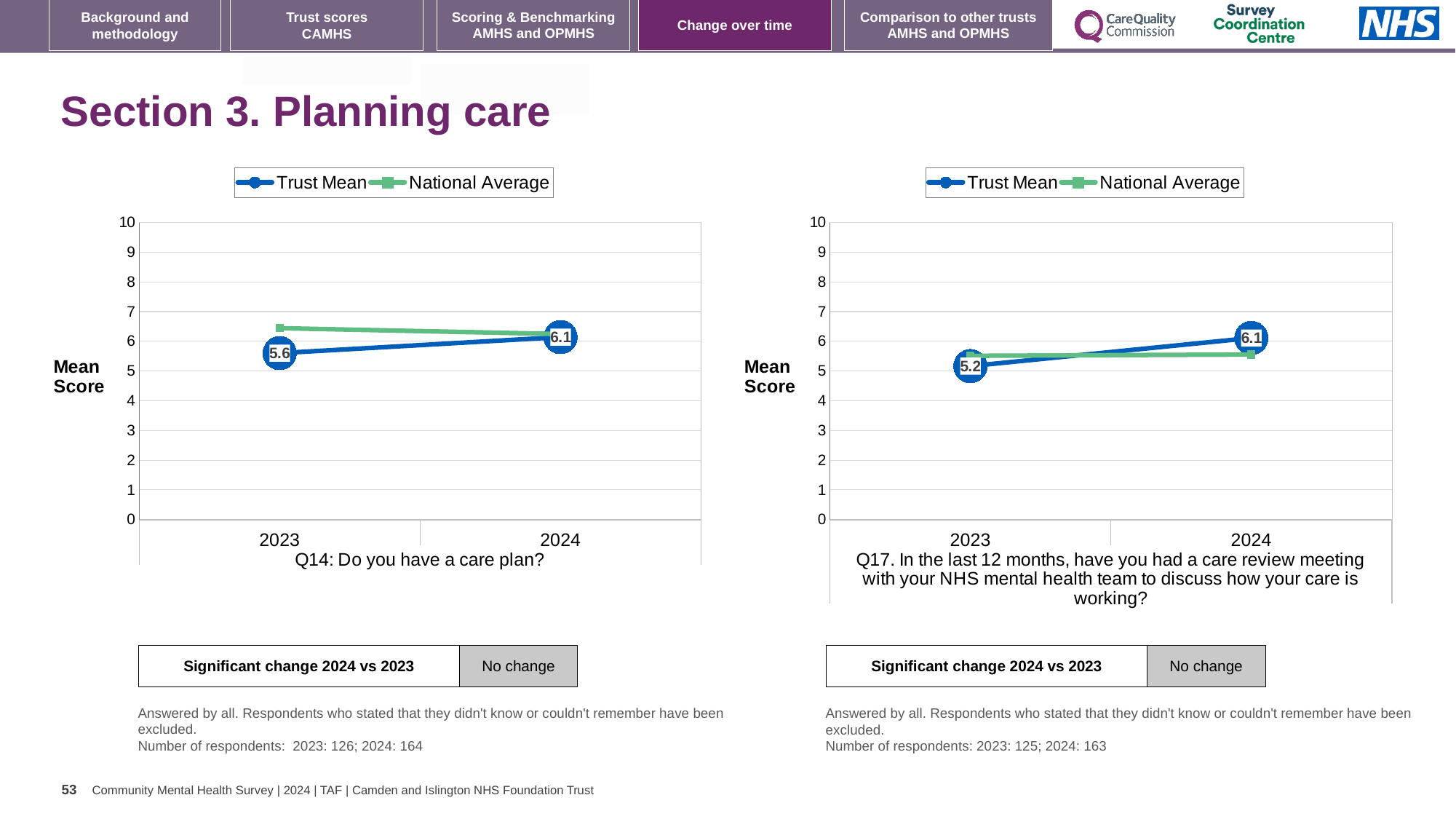
In the Q14 chart (left), what is the Trust Mean score for 2024? 6.1 In the Q14 chart (left), what is the Trust Mean score for 2023? 5.6 In the Q17 chart (right), what is the Trust Mean score for 2024? 6.1 In the Q14 chart (left), does the National Average rise or fall from 2023 to 2024? fall In the Q17 chart (right), what is the Trust Mean score for 2023? 5.2 In the Q17 chart (right), by how much did the Trust Mean change from 2023 to 2024? 0.9 How many series does the legend of the Q14 chart (left) list? 2 In the Q17 chart (right), is the National Average for 2023 greater or less than 6? less In the Q14 chart (left), by how much did the Trust Mean change from 2023 to 2024? 0.5 In the Q17 chart (right), does the Trust Mean rise or fall from 2023 to 2024? rise In the Q17 chart (right), which is higher in 2024, the Trust Mean or the National Average? Trust Mean In the Q14 chart (left), which is higher in 2023, the Trust Mean or the National Average? National Average